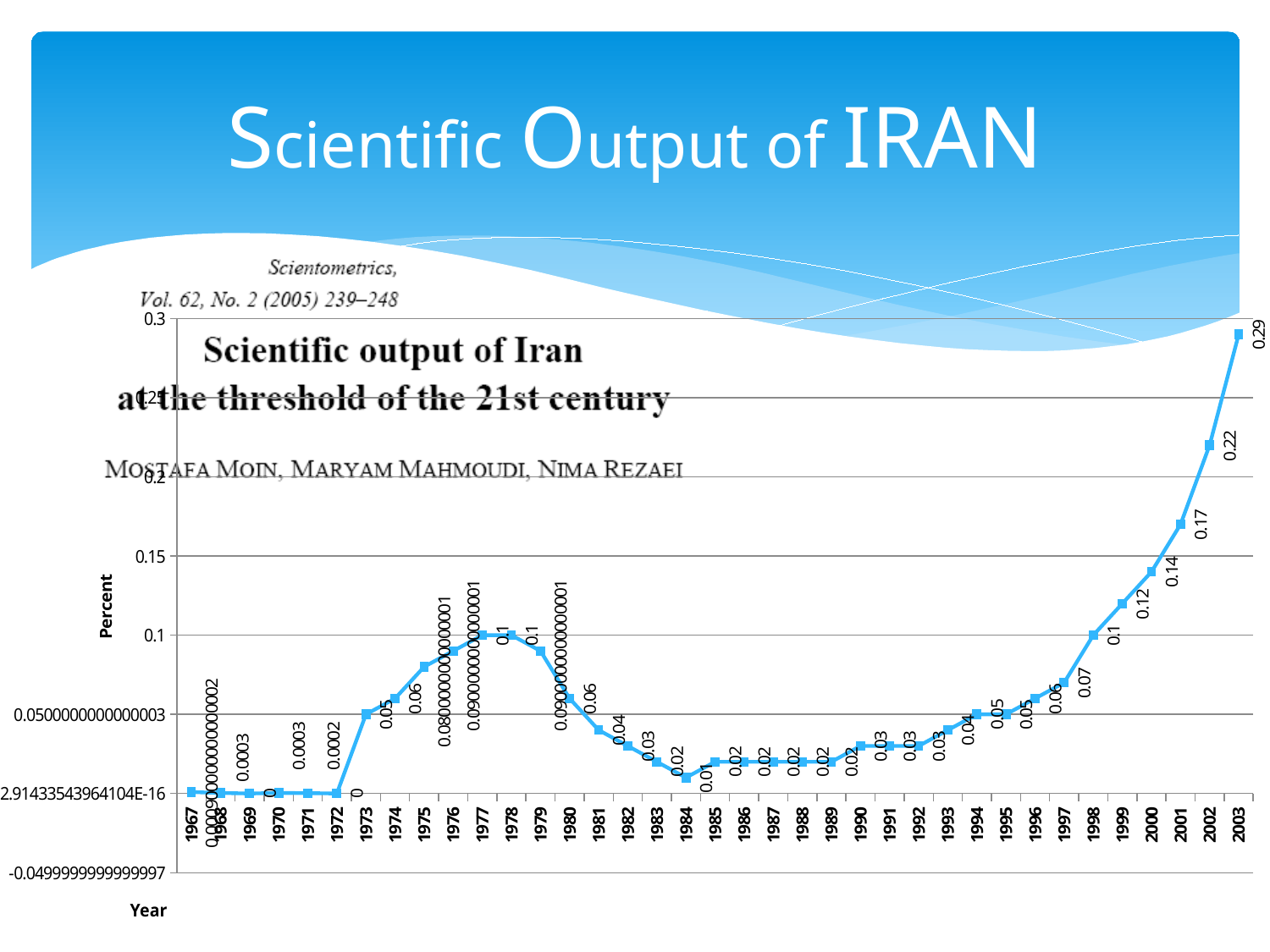
What is the value for 2000? 0.14 What kind of chart is shown on the slide? line chart Which is larger, the value for 2003 or the value for 1978? 2003 What is the value for 2003? 0.29 What is the value for 2001? 0.17 Do the values rise or fall from 1997 to 2003? rise What is the difference between the values for 2003 and 2002? 0.07 What is the label on the horizontal axis? Year What is the label on the vertical axis? Percent Which year has the highest value? 2003 Is the value for 2003 greater or less than 0.25? greater What is the value for 2002? 0.22